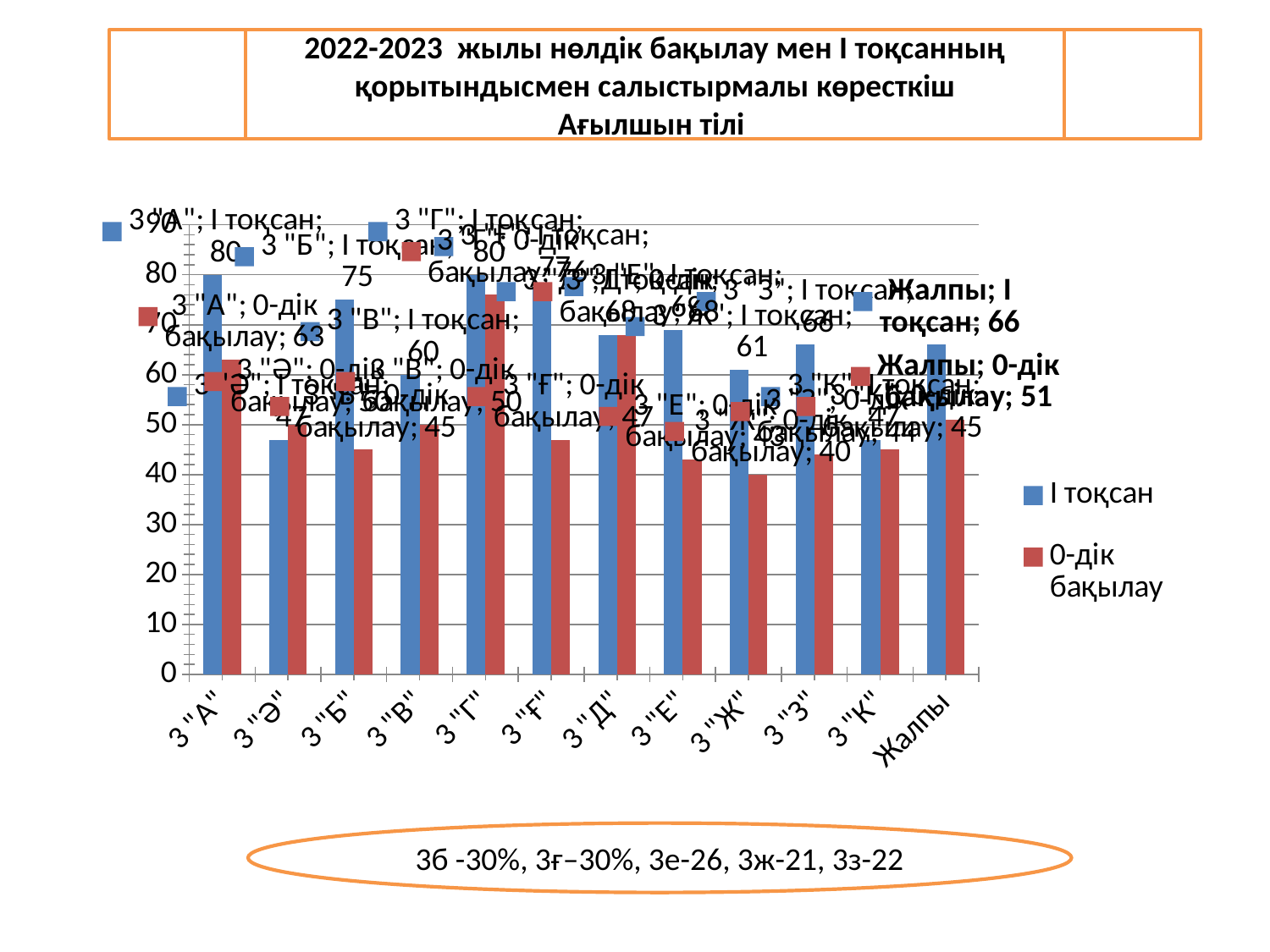
What is the І тоқсан value for 3 "А"? 80 What is the І тоқсан value for 3 "Ғ"? 77 How many series does the legend list? 2 What kind of chart is shown on the slide? bar chart Which has the larger І тоқсан value, 3 "А" or 3 "Ә"? 3 "А" What is the І тоқсан value for Жалпы? 66 Which series is shown in red in the legend? 0-дік бақылау What is the 0-дік бақылау value for Жалпы? 51 What is the І тоқсан value for 3 "Б"? 75 How many categories are shown along the x axis? 12 Is the 0-дік бақылау value for 3 "Ж" greater or less than 50? less What is the difference between the І тоқсан and 0-дік бақылау values for Жалпы? 15